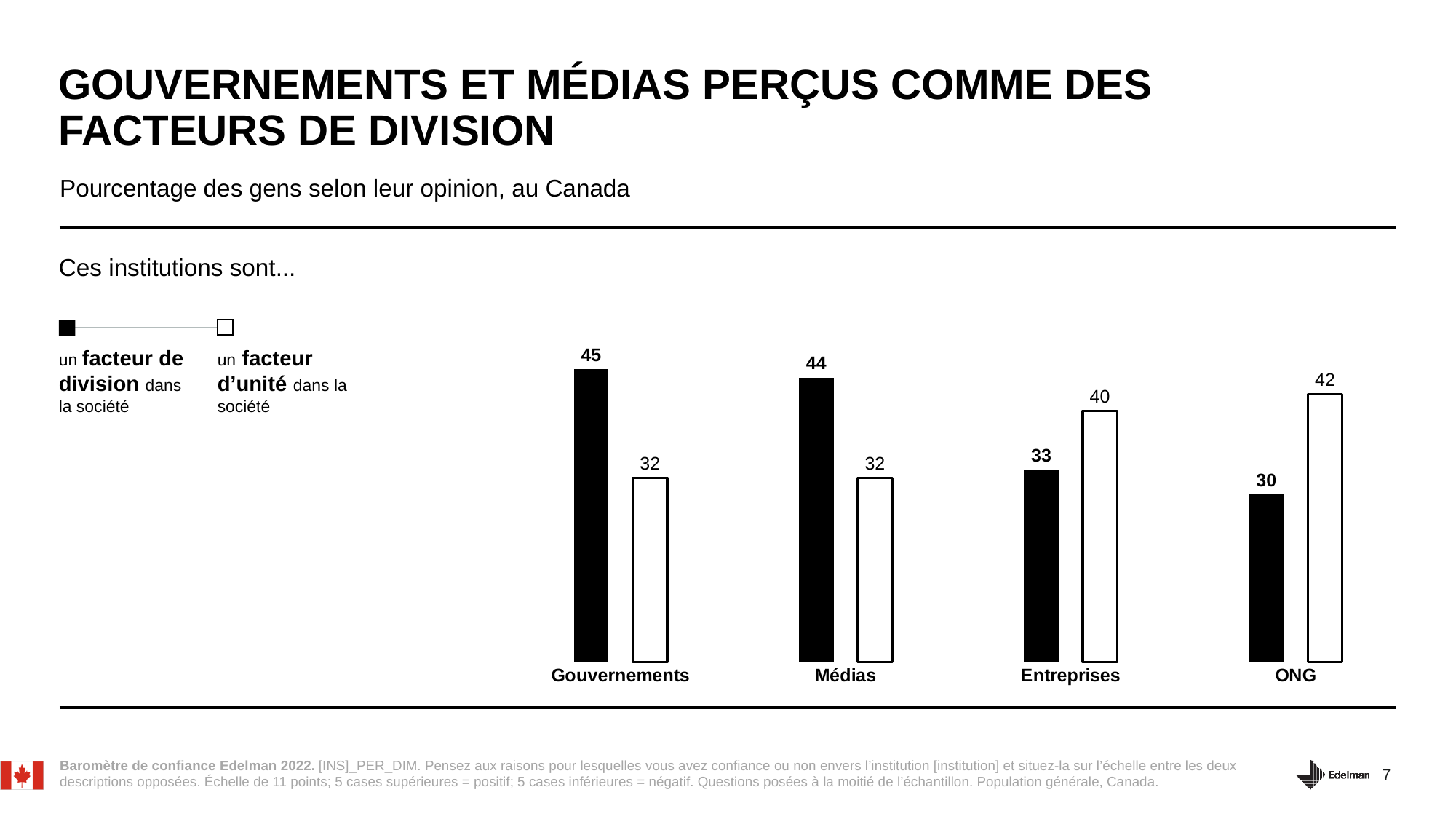
What is the value for Entreprises as a factor of division? 33 What percentage of people see Gouvernements as a factor of division in society? 45 What is the difference between the division and unity values for Gouvernements? 13 Which institution has the lowest value for 'facteur de division'? ONG How many series does the legend list? 2 Which institution has the highest value for 'facteur de division'? Gouvernements What percentage of people see ONG as a factor of unity in society? 42 Which colour represents 'un facteur de division dans la société' in the legend? Black What kind of chart is shown on the slide? Bar chart How many institutions are shown on the chart? 4 For Entreprises, which is larger: the 'facteur de division' value or the 'facteur d'unité' value? facteur d'unité Which institution has the highest value for 'facteur d'unité'? ONG